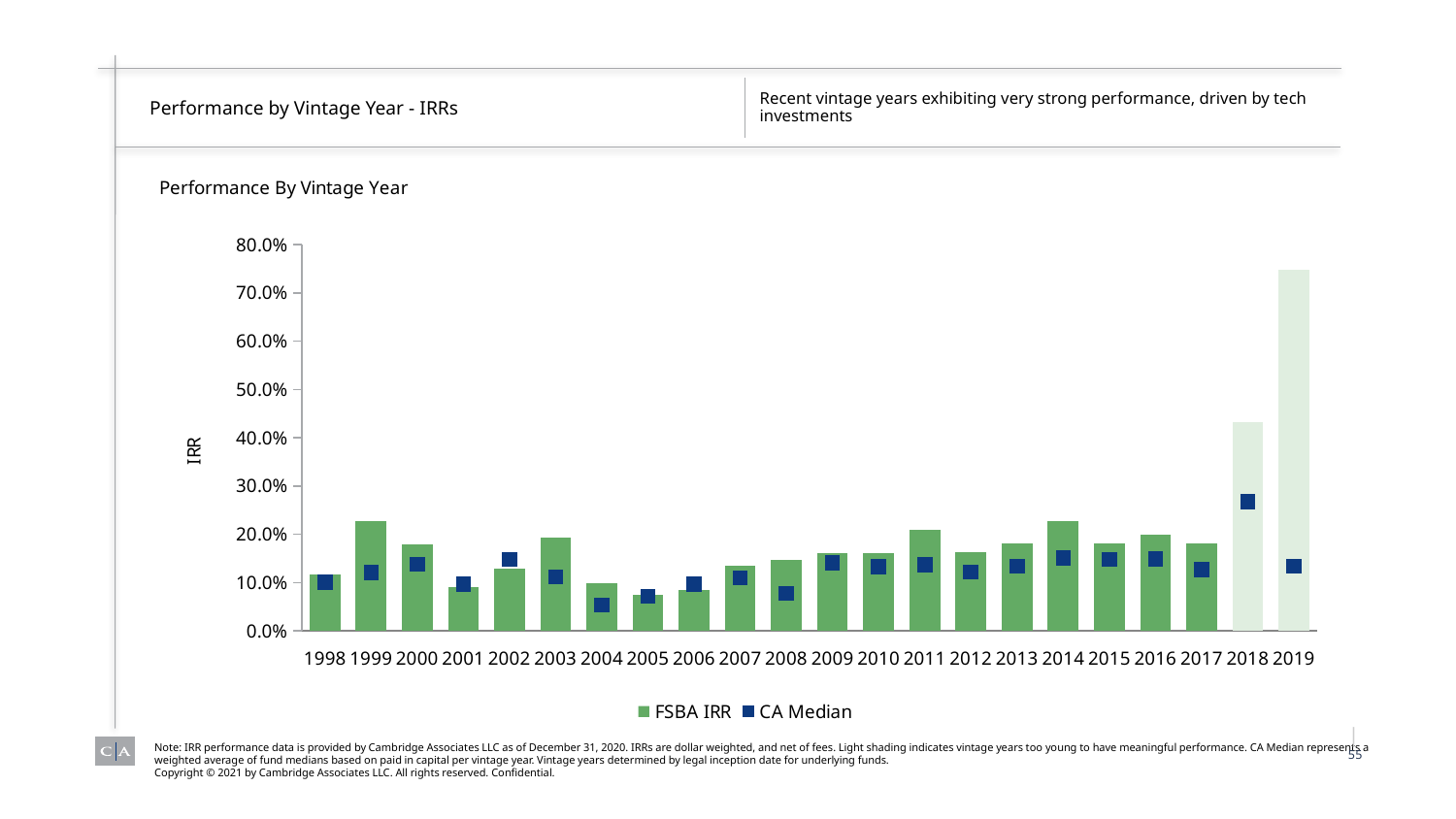
Is the FSBA IRR for 2018 greater or less than 40.0%? greater How many series does the legend list? 2 What is the label on the y axis? IRR How many vintage years are shown on the x axis? 22 Is the CA Median for 2004 greater or less than 10.0%? less For vintage year 2002, which is larger, the FSBA IRR or the CA Median? CA Median Which vintage year has the lowest FSBA IRR? 2005 What type of chart is shown on the slide? bar chart Is the FSBA IRR for 2019 greater or less than 70.0%? greater Which vintage year has the highest CA Median? 2018 Which vintage year has the lowest CA Median? 2004 Which vintage year has the highest FSBA IRR? 2019